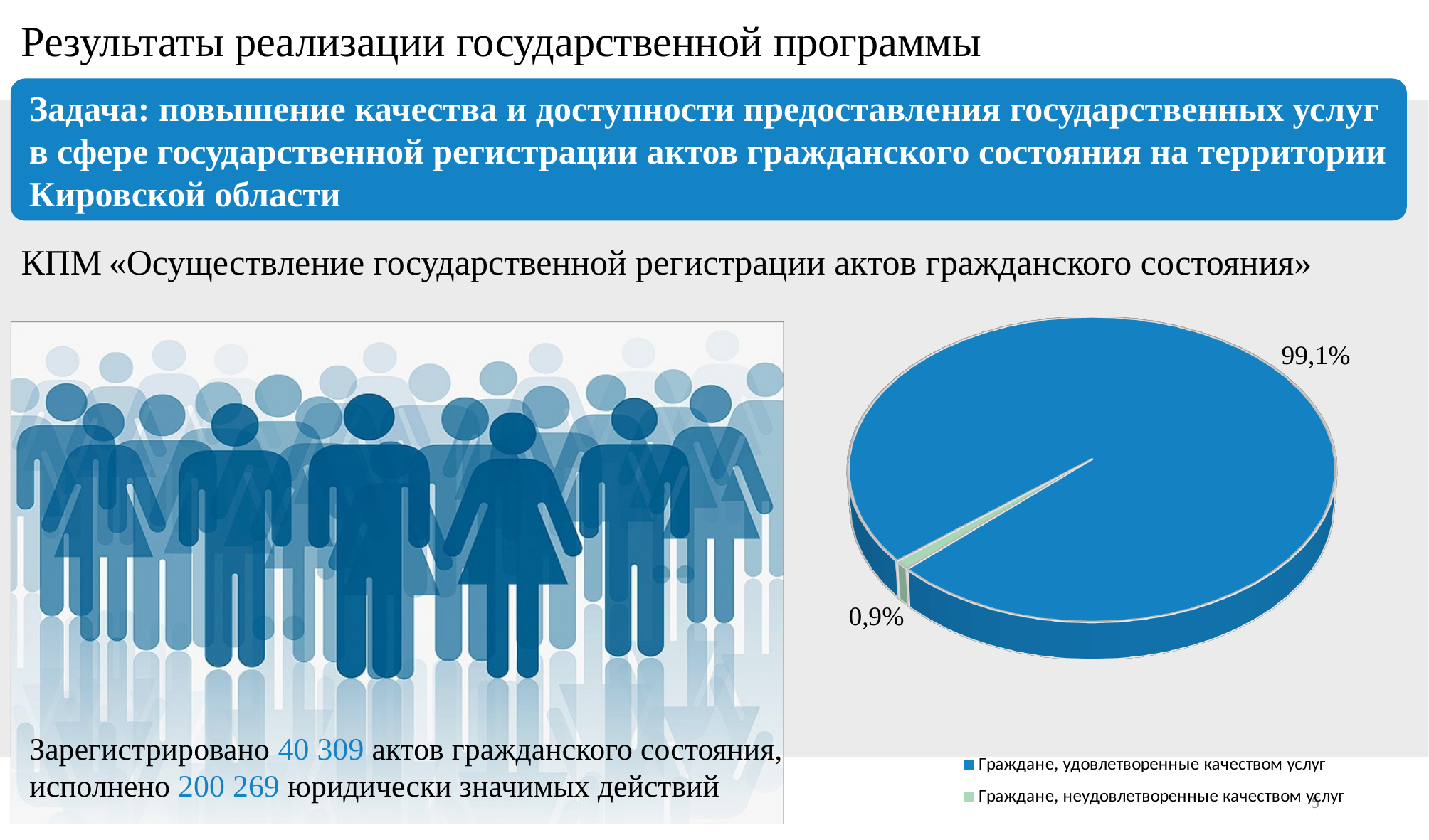
What kind of chart is shown on the slide? Pie chart What colour is the slice for citizens satisfied with the quality of services? Blue What share of the pie is labelled for citizens satisfied with the quality of services (Граждане, удовлетворенные качеством услуг)? 99,1% Which category has the largest slice of the pie? Граждане, удовлетворенные качеством услуг How many slices does the pie chart have? 2 Which category has the smallest slice of the pie? Граждане, неудовлетворенные качеством услуг What share of the pie is labelled for citizens not satisfied with the quality of services (Граждане, неудовлетворенные качеством услуг)? 0,9% What colour is the slice for citizens not satisfied with the quality of services? Light green Which slice is larger: satisfied citizens or unsatisfied citizens? Граждане, удовлетворенные качеством услуг What is the difference in percentage points between the satisfied and unsatisfied citizens' slices? 98,2 How many entries does the legend list? 2